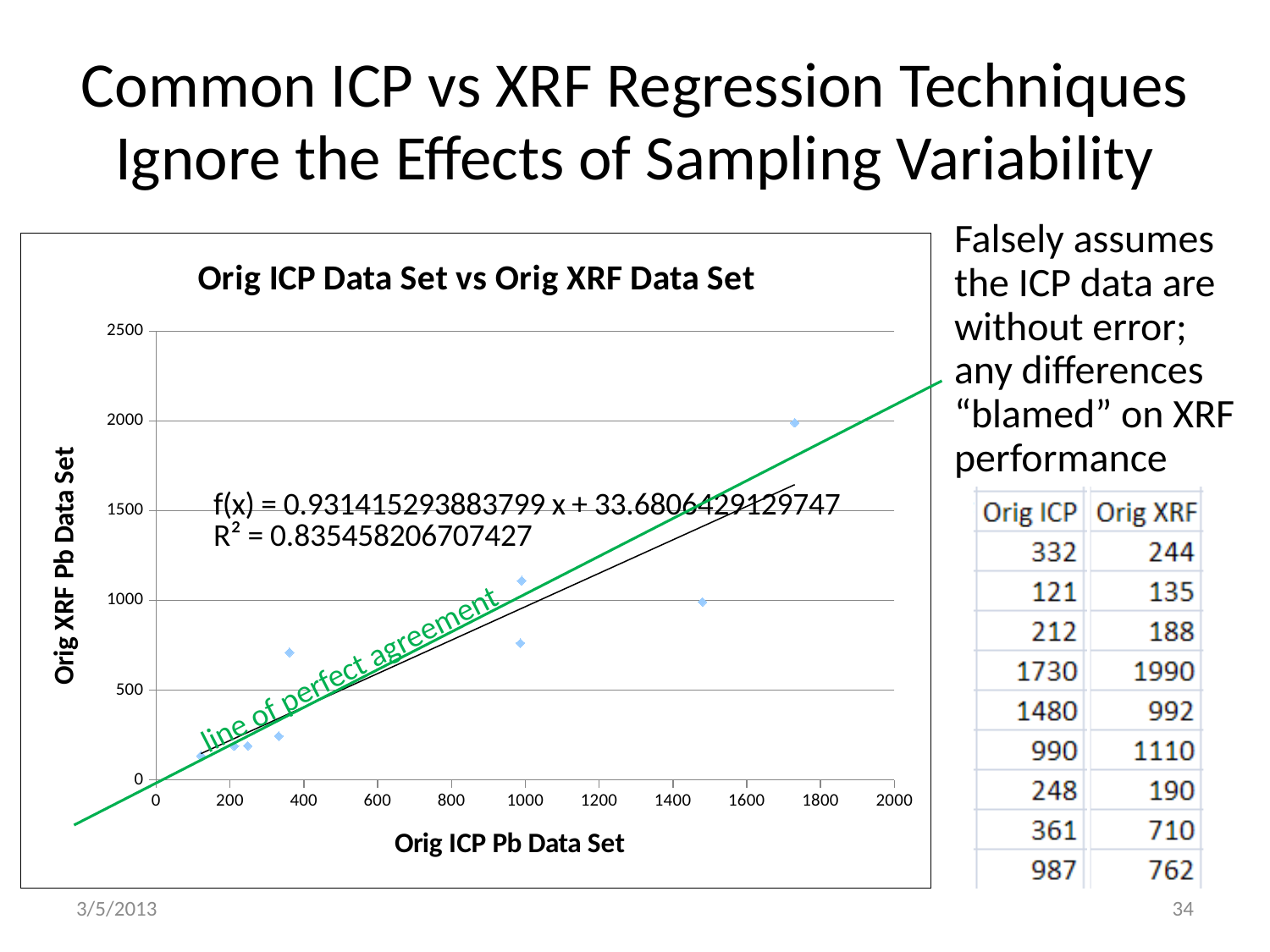
What kind of chart is shown on the slide? scatter chart How many data points are plotted on the chart? 9 Which Orig ICP value corresponds to the highest Orig XRF Pb value on the chart? 1730 According to the table, what is the Orig XRF value for the point with Orig ICP value 1730? 1990 Do the Orig XRF Pb values generally rise or fall as the Orig ICP Pb values increase along the x axis? rise Which Orig ICP value corresponds to the lowest Orig XRF Pb value on the chart? 121 What is the R² value shown on the chart? 0.835458206707427 What is the label of the green line drawn on the chart? line of perfect agreement Is the Orig XRF value for the point with Orig ICP value 361 greater or less than 500? greater What is the title of the chart? Orig ICP Data Set vs Orig XRF Data Set Is the Orig XRF value for the point with Orig ICP value 1730 greater or less than 1500? greater What is the trendline equation shown on the chart? f(x) = 0.931415293883799 x + 33.6806429129747